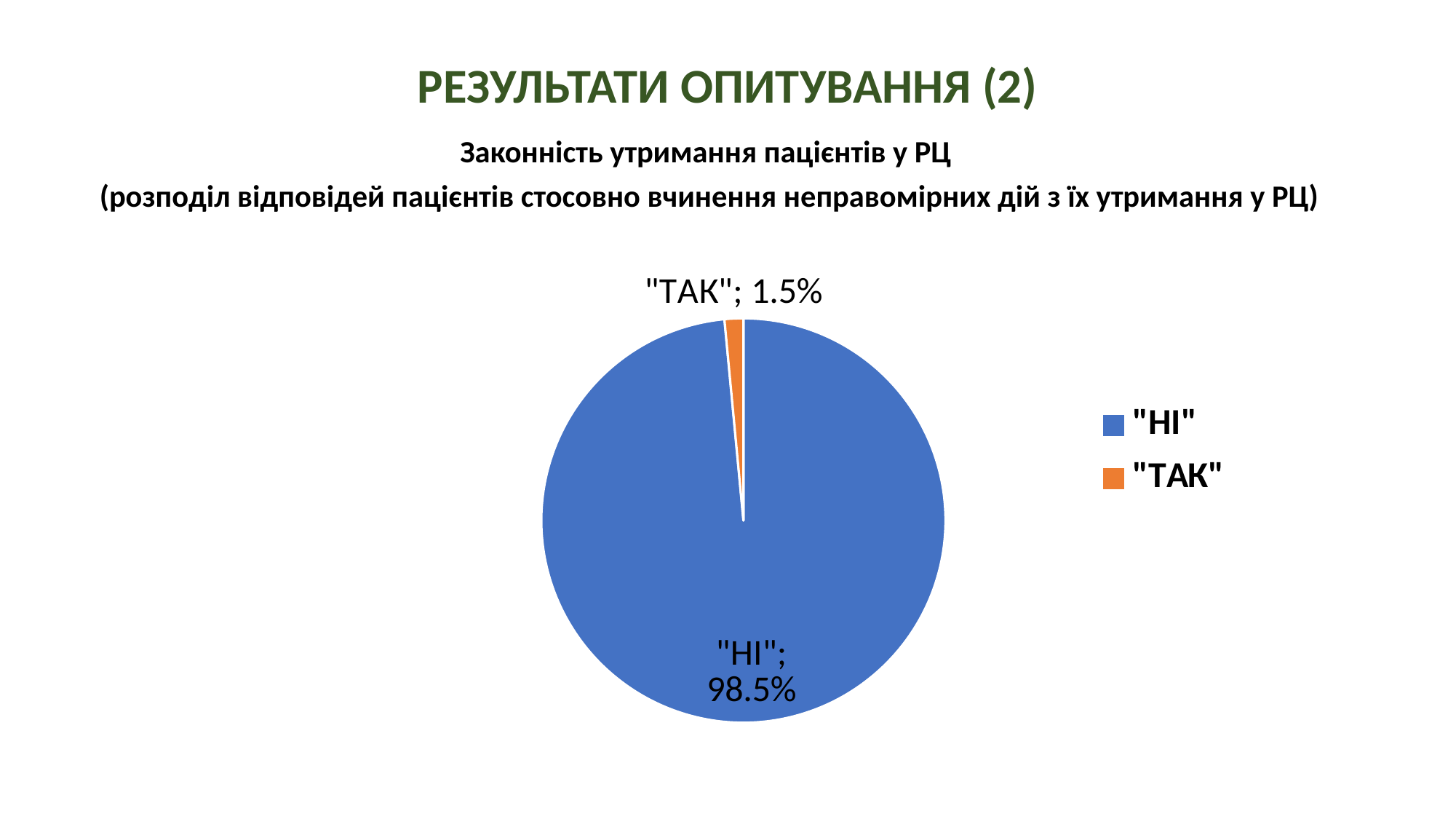
What colour is the "НІ" slice? blue What colour is the "ТАК" slice? orange What share of the pie does the "ТАК" slice represent? 1.5% How many entries does the legend list? 2 Which answer has the smallest share of the pie? "ТАК" Which slice is larger, "НІ" or "ТАК"? "НІ" How many slices does the pie chart have? 2 What type of chart is shown on the slide? pie chart What percentage of patients answered "НІ"? 98.5% What percentage of patients answered "ТАК"? 1.5% What is the difference in percentage points between the "НІ" and "ТАК" slices? 97 Which answer has the largest share of the pie? "НІ"